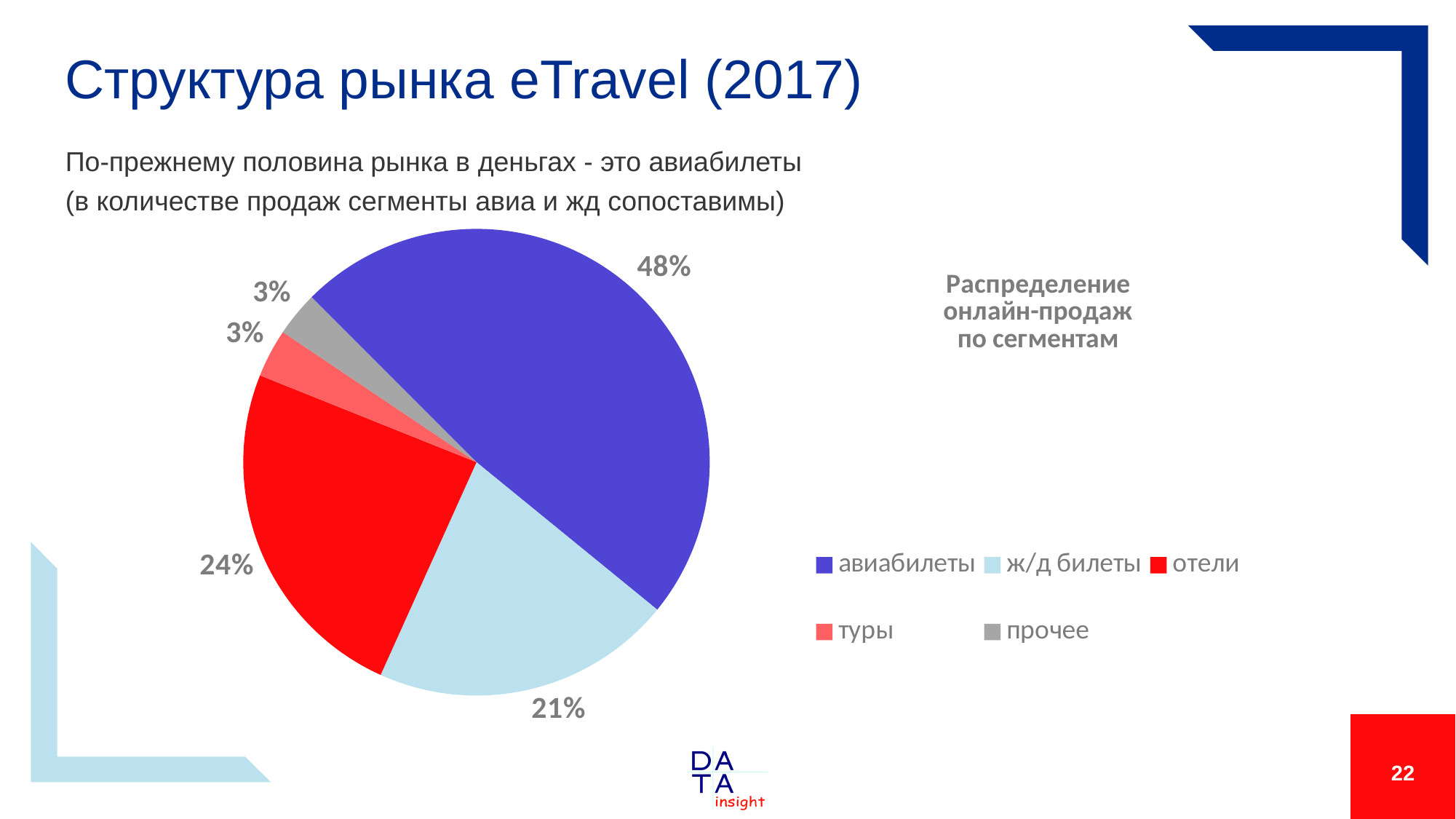
What kind of chart is shown on the slide? pie chart What share of online sales do туры account for? 3% What share of online sales do авиабилеты account for? 48% What is the difference in percentage points between the share of отели and the share of ж/д билеты? 3 How many segments does the pie chart show? 5 Which is larger, the share of отели or the share of ж/д билеты? отели What is the difference in percentage points between the share of авиабилеты and the share of отели? 24 What share of online sales do ж/д билеты account for? 21% How many entries does the legend list? 5 What share of online sales do отели account for? 24% Which segment has the largest share of online sales? авиабилеты What is the title of the pie chart? Распределение онлайн-продаж по сегментам